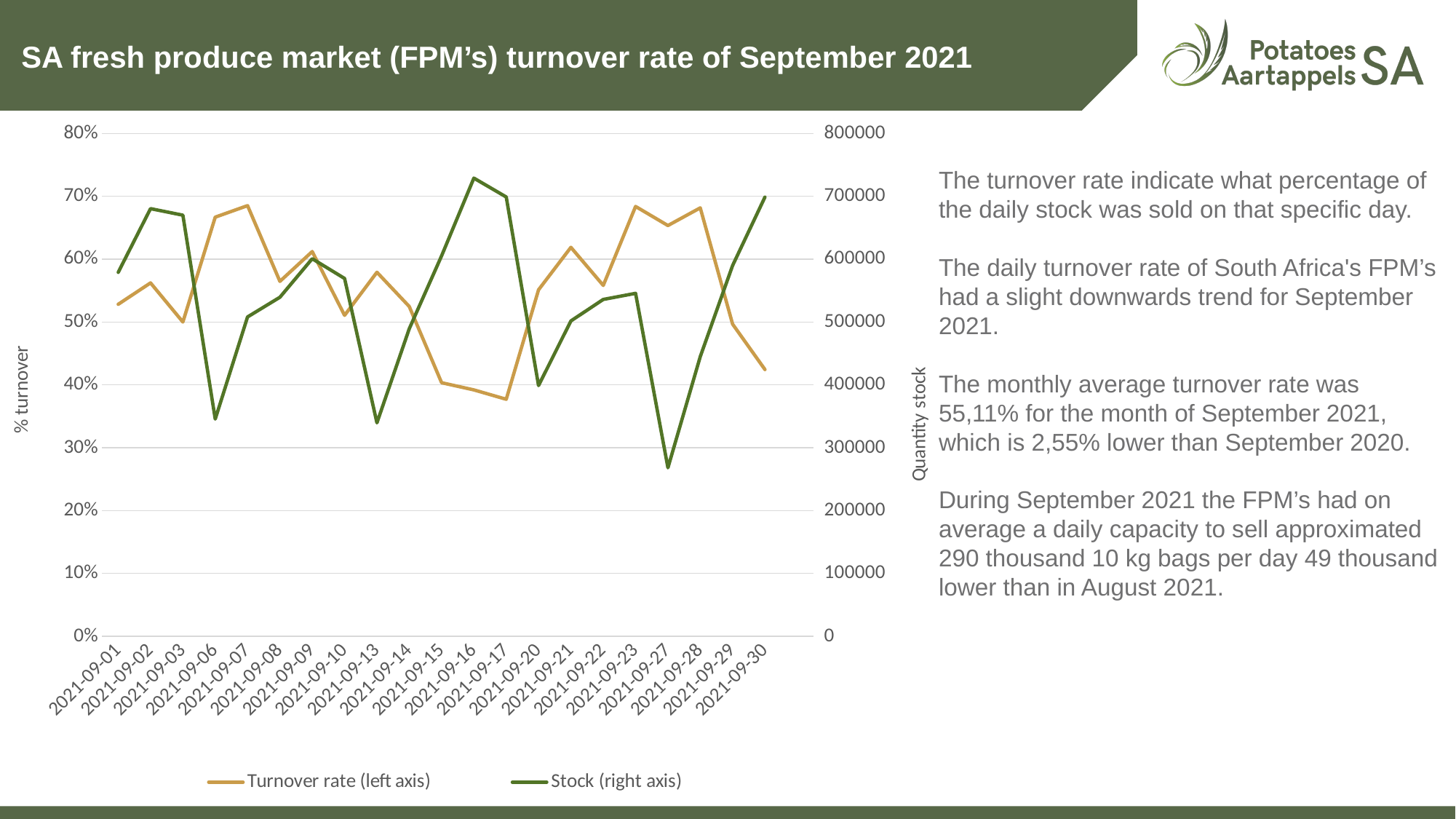
How many dates are plotted along the x axis of the chart? 21 Is the Stock value on 2021-09-06 greater or less than 400000? less Does the Stock value rise or fall from 2021-09-27 to 2021-09-30? rise Which date has the higher Stock value, 2021-09-02 or 2021-09-27? 2021-09-02 On which date is the Turnover rate (left axis) lowest? 2021-09-17 What kind of chart is shown on the slide? Line chart How many series does the chart legend list? 2 Is the Stock value on 2021-09-30 greater or less than 600000? greater On which date is the Stock (right axis) value lowest? 2021-09-27 Is the Turnover rate on 2021-09-17 greater or less than 40%? less On which date is the Stock (right axis) value highest? 2021-09-16 Which date has the higher Turnover rate, 2021-09-01 or 2021-09-07? 2021-09-07